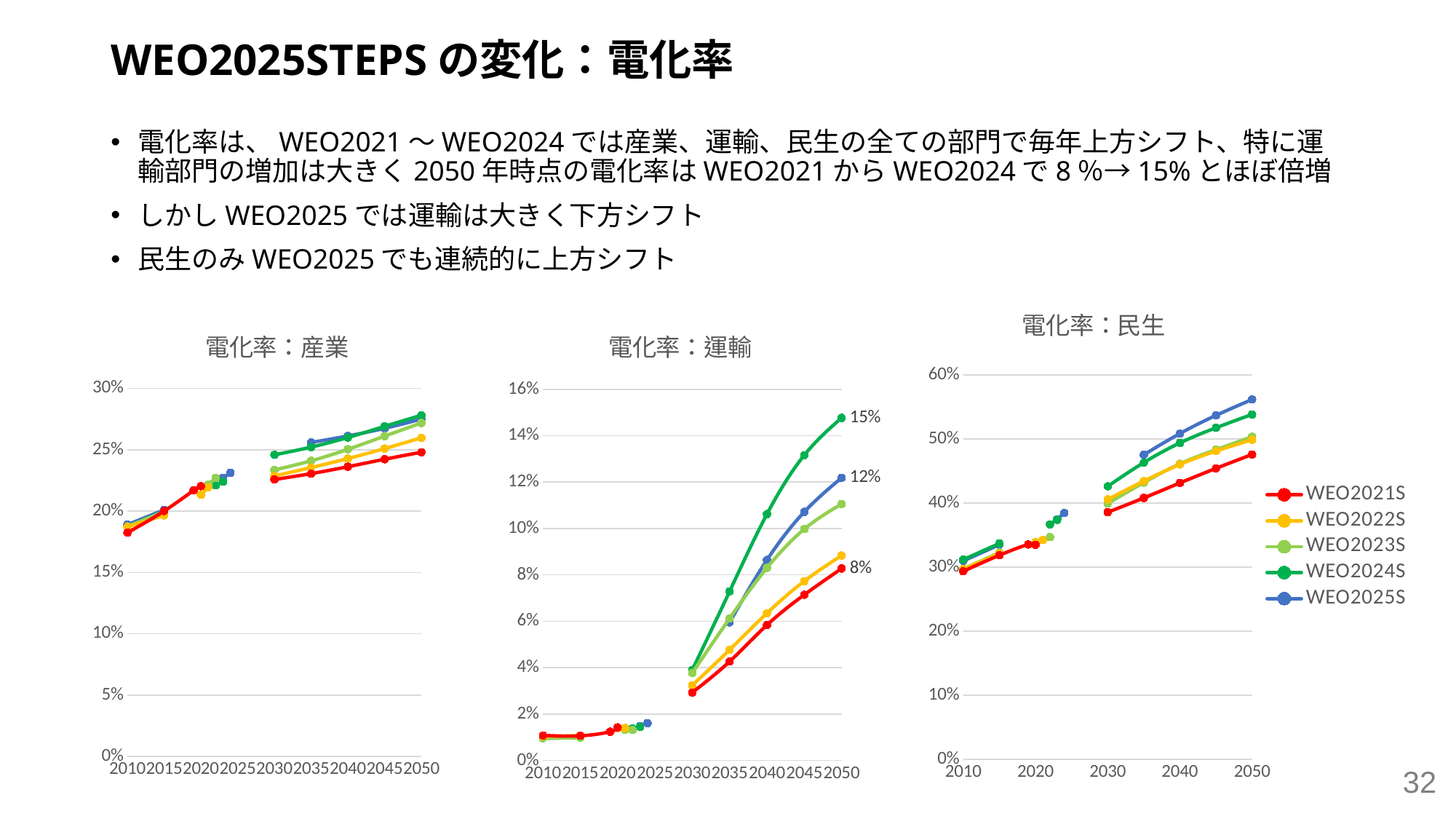
In the 電化率：運輸 chart, what is the value for WEO2025S in 2050? 12% In the 電化率：民生 chart, which series has the highest value in 2050? WEO2025S In the 電化率：産業 chart, does the WEO2021S series rise or fall from 2010 to 2050? rise In the 電化率：運輸 chart, what is the value for WEO2021S in 2050? 8% In the 電化率：産業 chart, is the value for WEO2024S in 2050 greater or less than 25%? greater In the 電化率：運輸 chart, which series has the highest value in 2050? WEO2024S In the 電化率：運輸 chart, which series has the lowest value in 2050? WEO2021S In the 電化率：民生 chart, is the value for WEO2025S in 2050 greater or less than 50%? greater What kind of chart is the 電化率：運輸 chart? line chart In the 電化率：運輸 chart, what is the value for WEO2024S in 2050? 15% How many series does the legend list for the charts on this slide? 5 In the 電化率：運輸 chart, what is the difference between the 2050 values of WEO2024S and WEO2021S? 7%